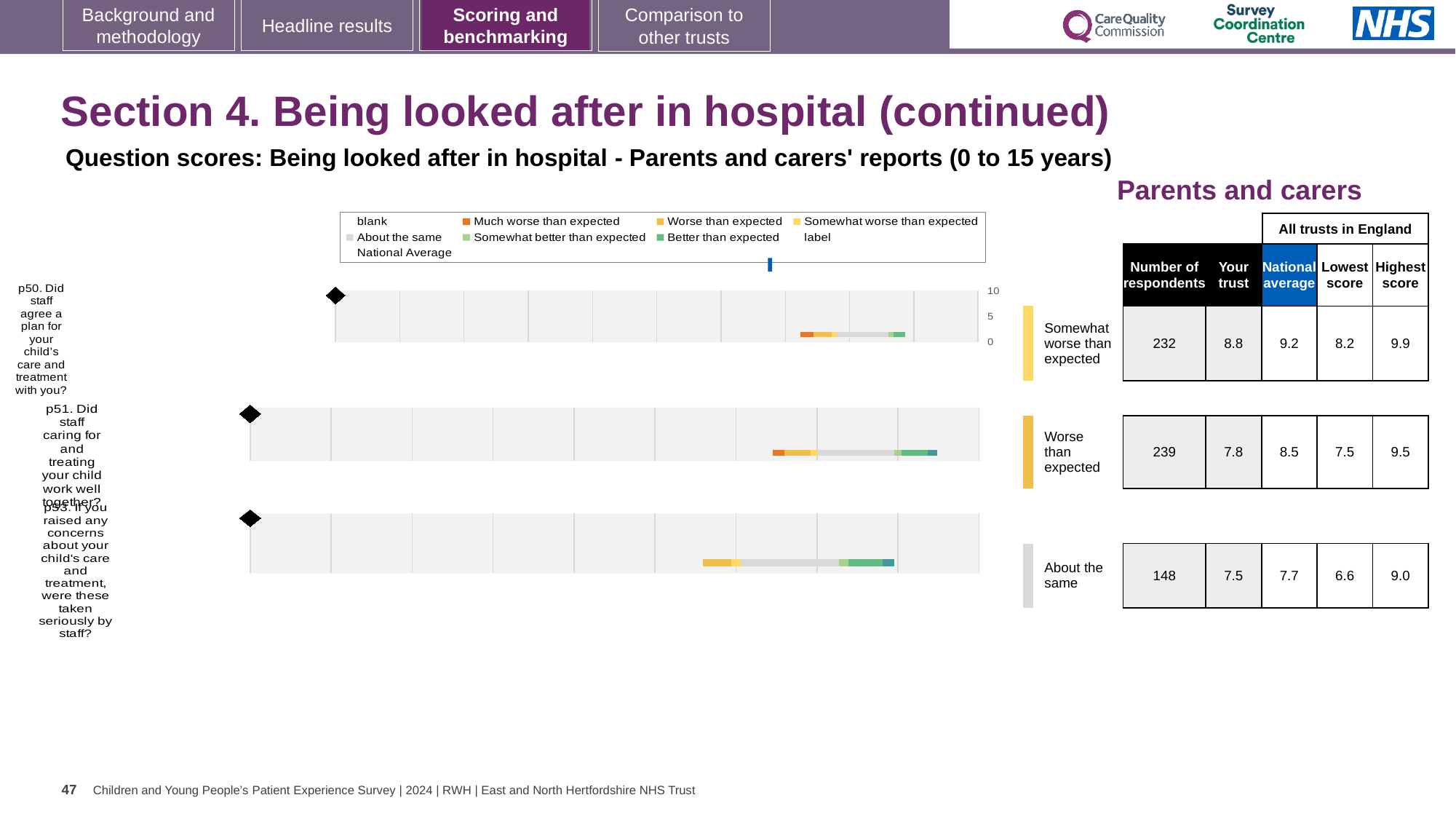
Is the 'Your trust' score for p50 higher or lower than the national average for p50? lower Which question has the lowest number of respondents? p53 What is the number of respondents for p51 (Did staff caring for and treating your child work well together)? 239 What is the highest score among all trusts in England for p50? 9.9 How many survey questions are plotted in the chart? 3 What is the national average score for p53 (If you raised any concerns about your child's care and treatment, were these taken seriously by staff)? 7.7 What is the lowest score among all trusts in England for p51? 7.5 What kind of chart is used to show the question scores? bar chart Which benchmark category is p51 rated as? Worse than expected Which question has the highest 'Your trust' score? p50 What is the 'Your trust' score for p50 (Did staff agree a plan for your child's care and treatment with you)? 8.8 What is the difference between the national average and the 'Your trust' score for p51? 0.7